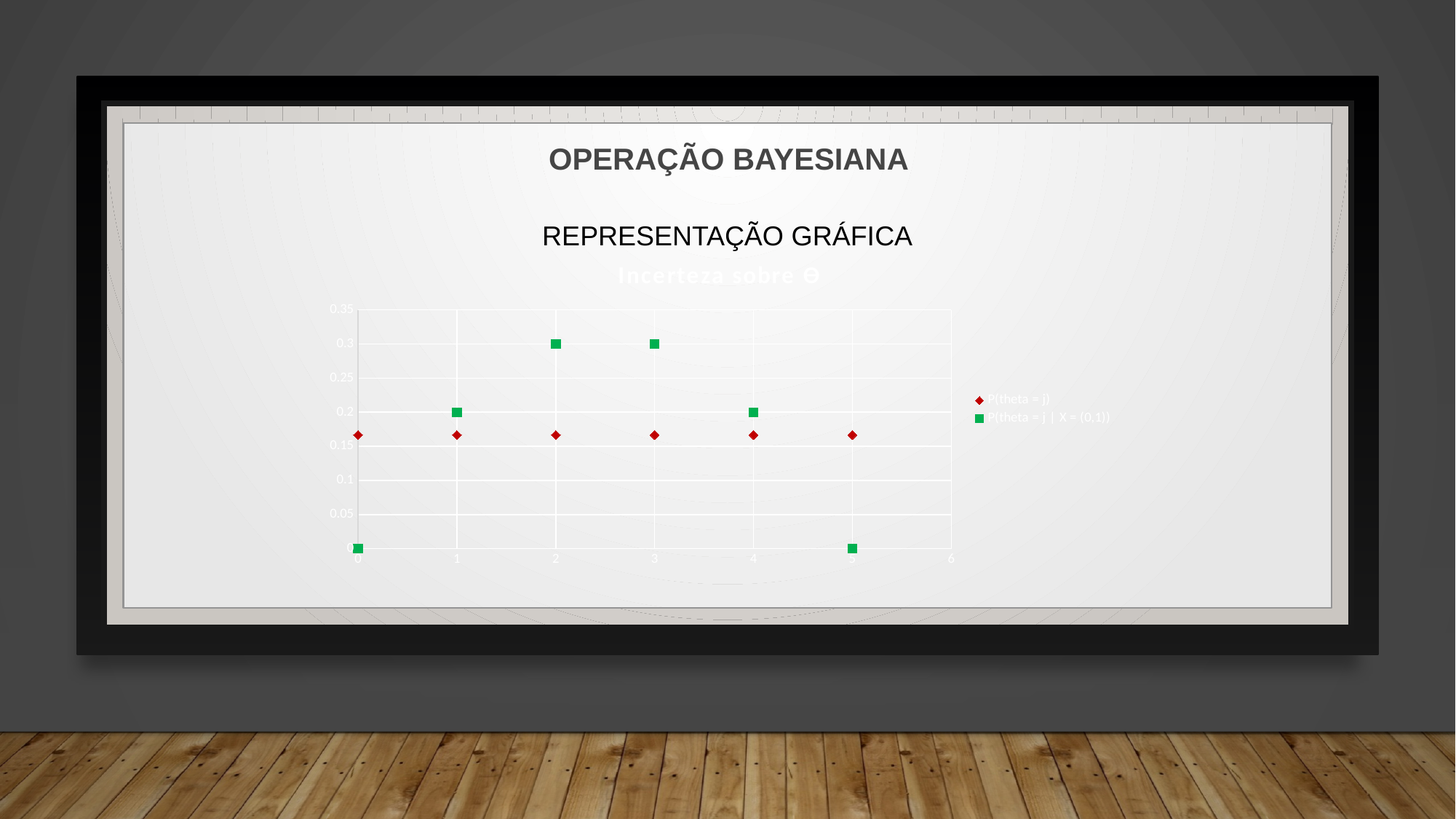
At x = 2, which series has the larger value, P(theta = j) or P(theta = j | X = (0,1))? P(theta = j | X = (0,1)) At which x values does the series P(theta = j | X = (0,1)) reach its highest value? 2 and 3 What is the value of P(theta = j | X = (0,1)) at x = 2? 0.3 How many points are plotted for the series P(theta = j | X = (0,1))? 6 Is the value of P(theta = j) at x = 3 greater or less than 0.2? less What is the difference between the values of P(theta = j | X = (0,1)) at x = 2 and at x = 1? 0.1 At which x values does the series P(theta = j | X = (0,1)) reach its lowest value? 0 and 5 What is the value of P(theta = j | X = (0,1)) at x = 1? 0.2 What kind of chart is shown on the slide? scatter chart How many series does the chart legend list? 2 What is the value of P(theta = j | X = (0,1)) at x = 5? 0 What is the title of the chart? Incerteza sobre Θ